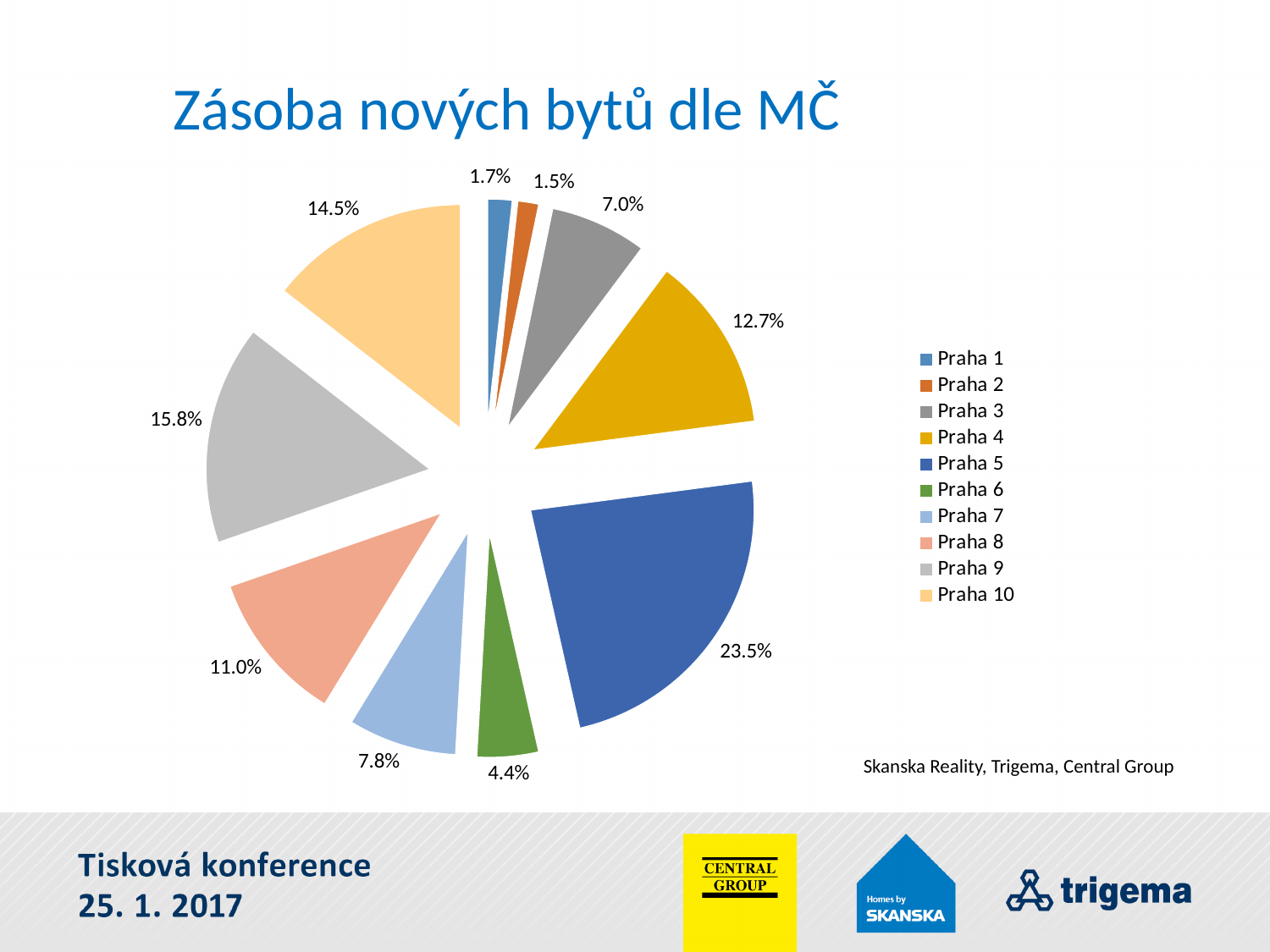
What type of chart is shown on the slide? Pie chart What is the value shown for Praha 4? 12.7% What is the value shown for Praha 9? 15.8% Which district has the largest share of the pie? Praha 5 Which has a larger share, Praha 8 or Praha 7? Praha 8 How many districts are shown in the pie chart? 10 What is the title of the chart? Zásoba nových bytů dle MČ What share of the pie does Praha 5 hold? 23.5% What is the value shown for Praha 6? 4.4% What is the difference in percentage points between Praha 5 and Praha 4? 10.8 Which district has the smallest share of the pie? Praha 2 What is the value shown for Praha 10? 14.5%